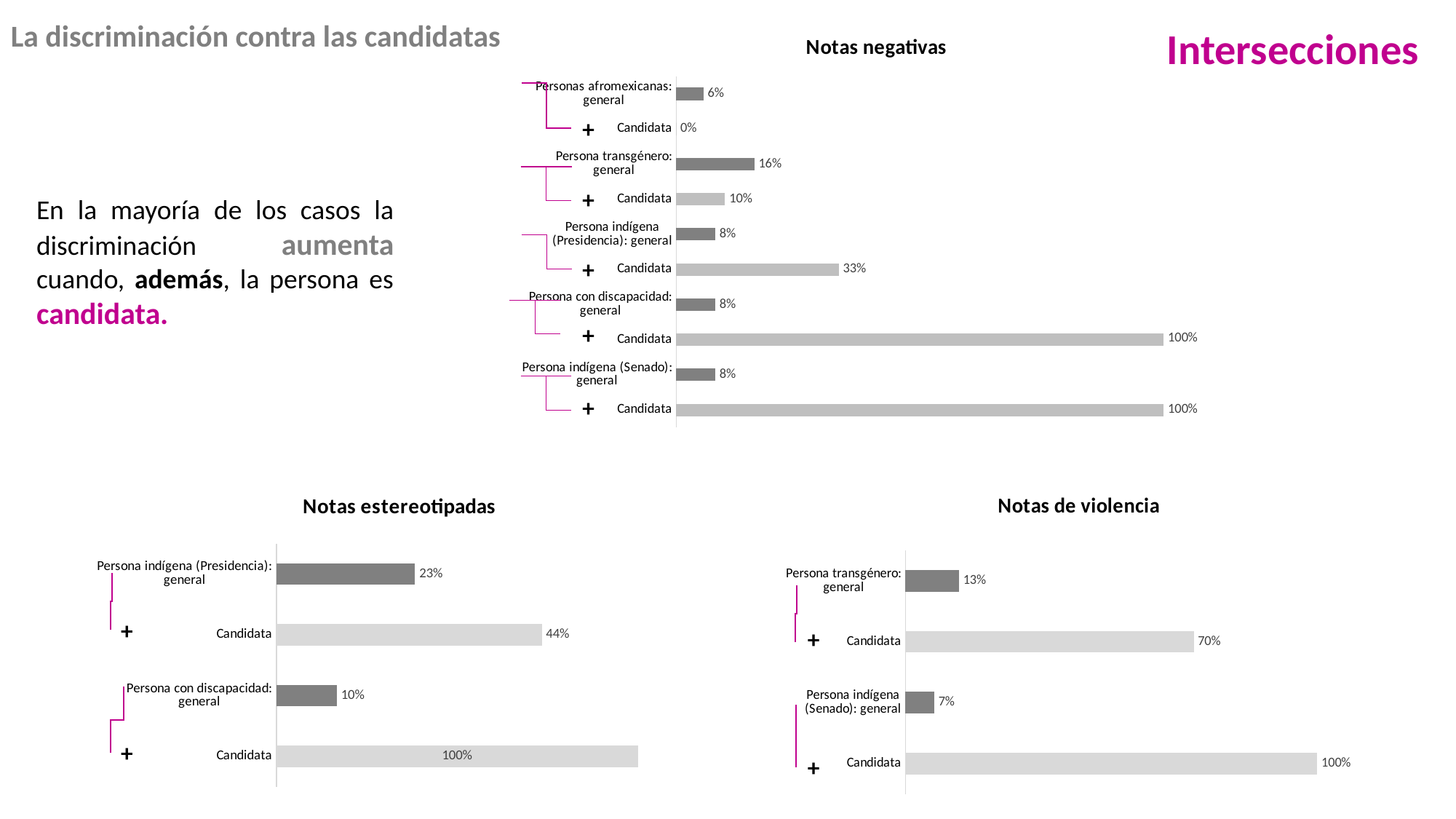
In the 'Notas estereotipadas' chart, what is the value for the Candidata bar under 'Persona con discapacidad'? 100% In the 'Notas negativas' chart, what is the value for the Candidata bar under 'Personas afromexicanas'? 0% In the 'Notas de violencia' chart, which is larger: 'Persona transgénero: general' or its Candidata bar? Candidata In the 'Notas estereotipadas' chart, what is the difference between the Candidata bar and the general bar for 'Persona indígena (Presidencia)'? 21% What type of chart is 'Notas de violencia'? Bar chart In the 'Notas estereotipadas' chart, what is the value for 'Persona indígena (Presidencia): general'? 23% In the 'Notas negativas' chart, what is the value for the Candidata bar under 'Persona indígena (Presidencia)'? 33% In the 'Notas negativas' chart, what is the value for 'Persona transgénero: general'? 16% In the 'Notas negativas' chart, what is the difference between the Candidata bar and the general bar for 'Persona transgénero'? 6% In the 'Notas de violencia' chart, which category has the lowest value? Persona indígena (Senado): general In the 'Notas de violencia' chart, what is the value for the Candidata bar under 'Persona transgénero'? 70%